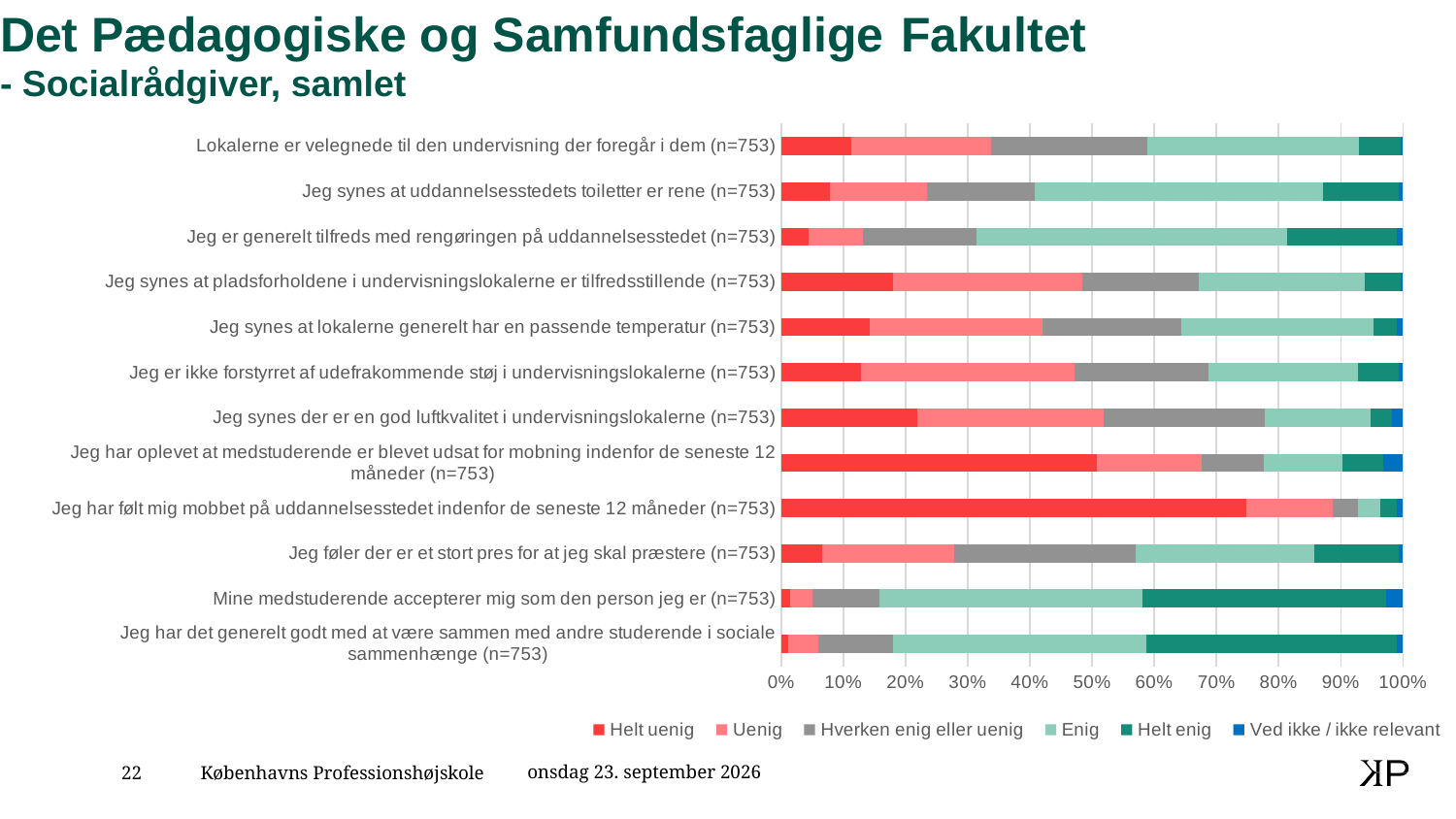
Which has the larger 'Helt uenig' share: 'Jeg synes der er en god luftkvalitet i undervisningslokalerne' or 'Jeg synes at uddannelsesstedets toiletter er rene'? Jeg synes der er en god luftkvalitet i undervisningslokalerne Which has the larger 'Helt enig' share: 'Mine medstuderende accepterer mig som den person jeg er' or 'Lokalerne er velegnede til den undervisning der foregår i dem'? Mine medstuderende accepterer mig som den person jeg er How many statements (categories) are plotted in the chart? 12 Is the 'Helt uenig' share for 'Jeg synes at pladsforholdene i undervisningslokalerne er tilfredsstillende' greater or less than 10%? greater What kind of chart is shown on the slide? Stacked bar chart Is the 'Helt uenig' share for 'Jeg har oplevet at medstuderende er blevet udsat for mobning indenfor de seneste 12 måneder' greater or less than 40%? greater What is the highest value shown on the x axis of the chart? 100% Which statement has the largest 'Helt uenig' share? Jeg har følt mig mobbet på uddannelsesstedet indenfor de seneste 12 måneder (n=753) How many series does the legend list? 6 Is the 'Helt uenig' share for 'Jeg har følt mig mobbet på uddannelsesstedet indenfor de seneste 12 måneder' greater or less than 70%? greater What is the last entry in the chart's legend? Ved ikke / ikke relevant